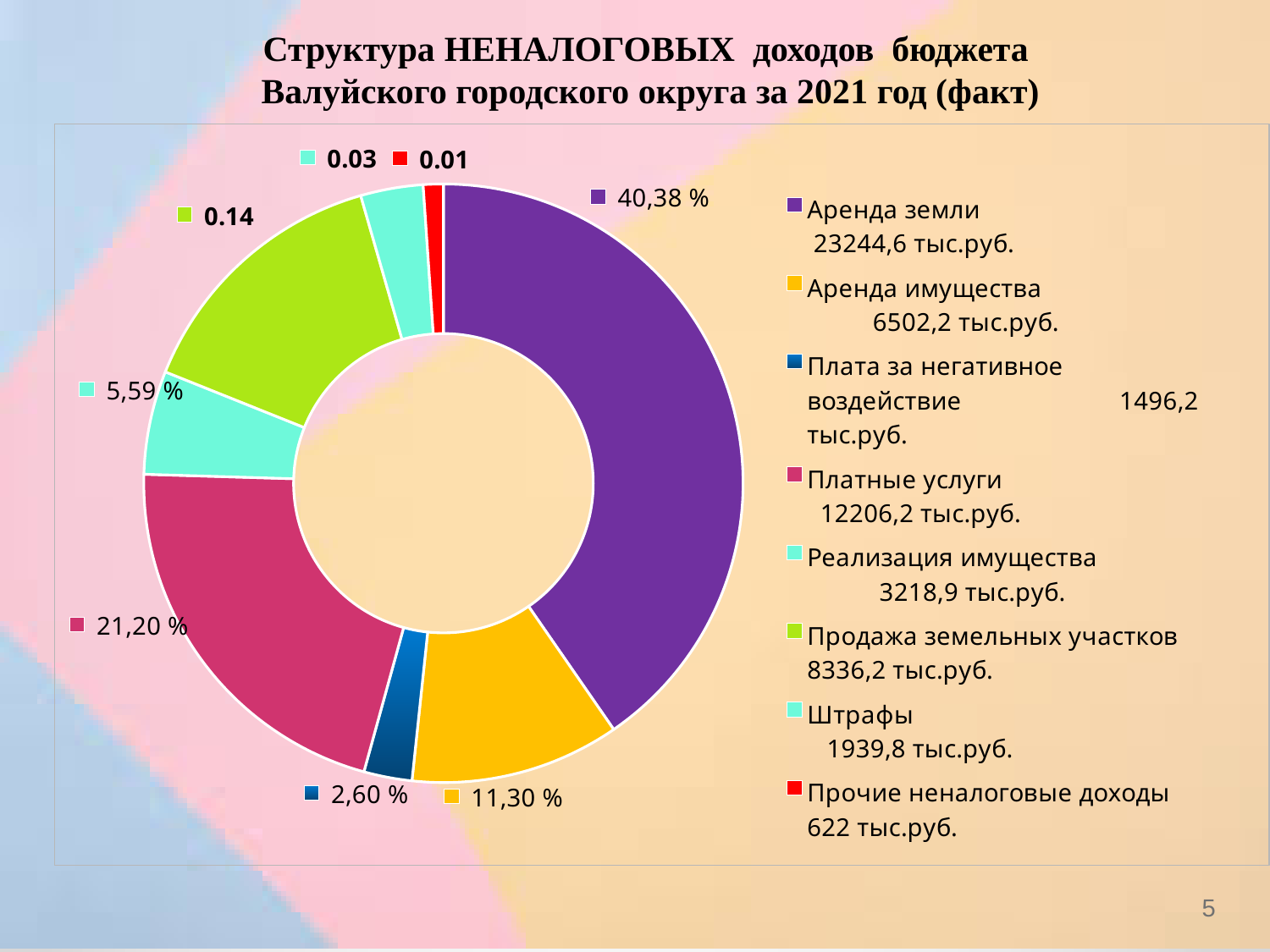
What share is shown for Платные услуги? 21,20 % What label is shown for the Плата за негативное воздействие slice? 2,60 % What amount in тыс.руб. is given in the legend for Штрафы? 1939,8 тыс.руб. How many categories does the chart show? 8 What share is shown for Аренда имущества? 11,30 % What is the difference in percentage points between the Аренда земли share and the Платные услуги share? 19,18 % Which is larger: the share for Платные услуги or the share for Аренда имущества? Платные услуги What amount in тыс.руб. is given in the legend for Продажа земельных участков? 8336,2 тыс.руб. What type of chart is shown on the slide? Pie (doughnut) chart Which category has the smallest share of non-tax revenue? Прочие неналоговые доходы What share of non-tax revenue does Аренда земли account for? 40,38 % Which category has the largest share of non-tax revenue? Аренда земли